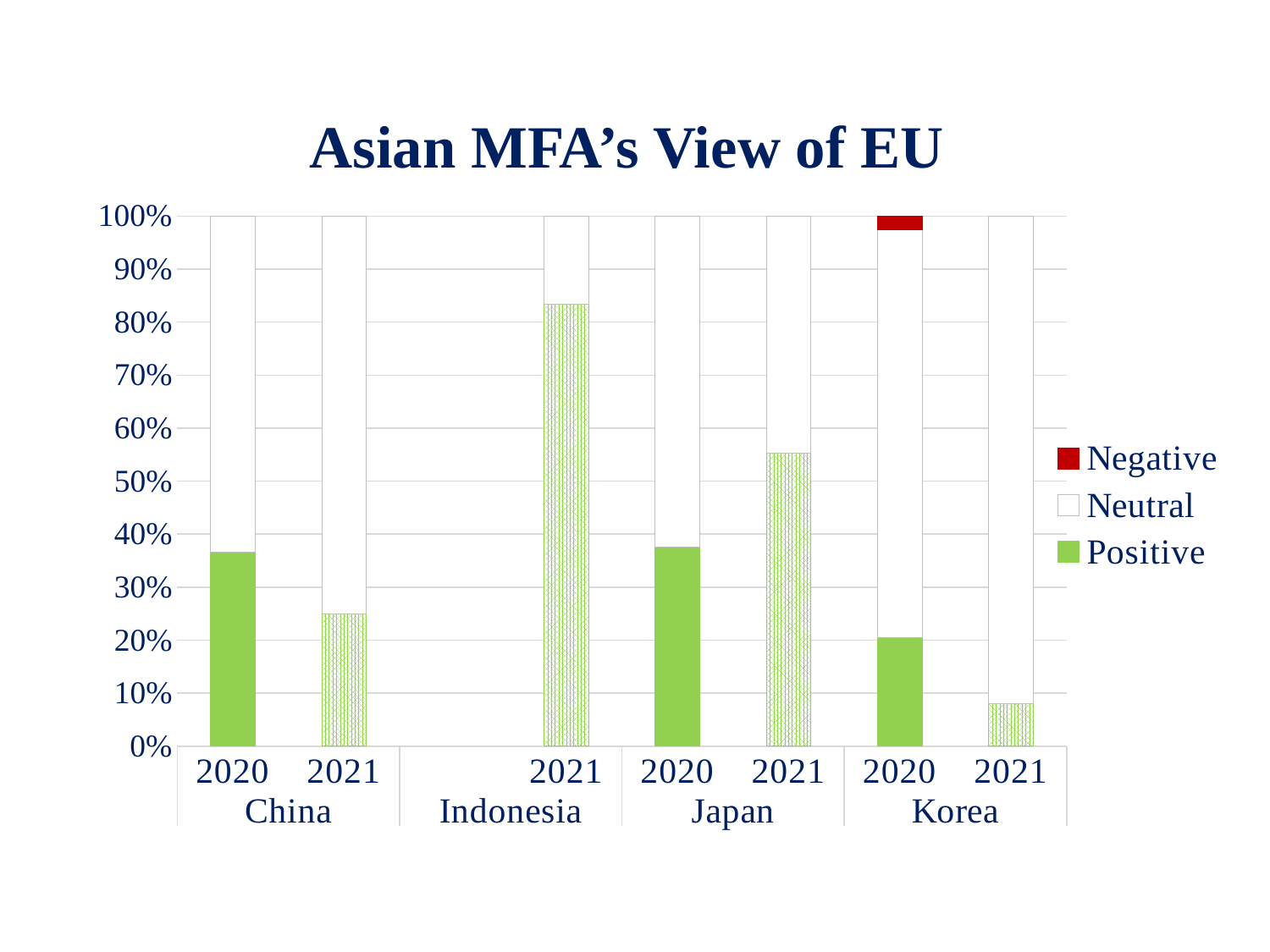
Is the Positive share for Korea 2021 greater or less than 10%? less Which bar is the only one showing a Negative segment? Korea 2020 Which bar has the smallest Positive share? Korea 2021 Is the Positive share for Japan 2021 greater or less than 50%? greater Is the Positive share for Indonesia 2021 greater or less than 80%? greater Which bar has the largest Positive share? Indonesia 2021 What is the title of the chart? Asian MFA's View of EU Did the Positive share for Japan rise or fall from 2020 to 2021? rise How many bars are plotted in the chart? 7 How many series does the legend list? 3 What kind of chart is shown on the slide? stacked bar chart Which is larger, the Positive share for China 2020 or China 2021? China 2020